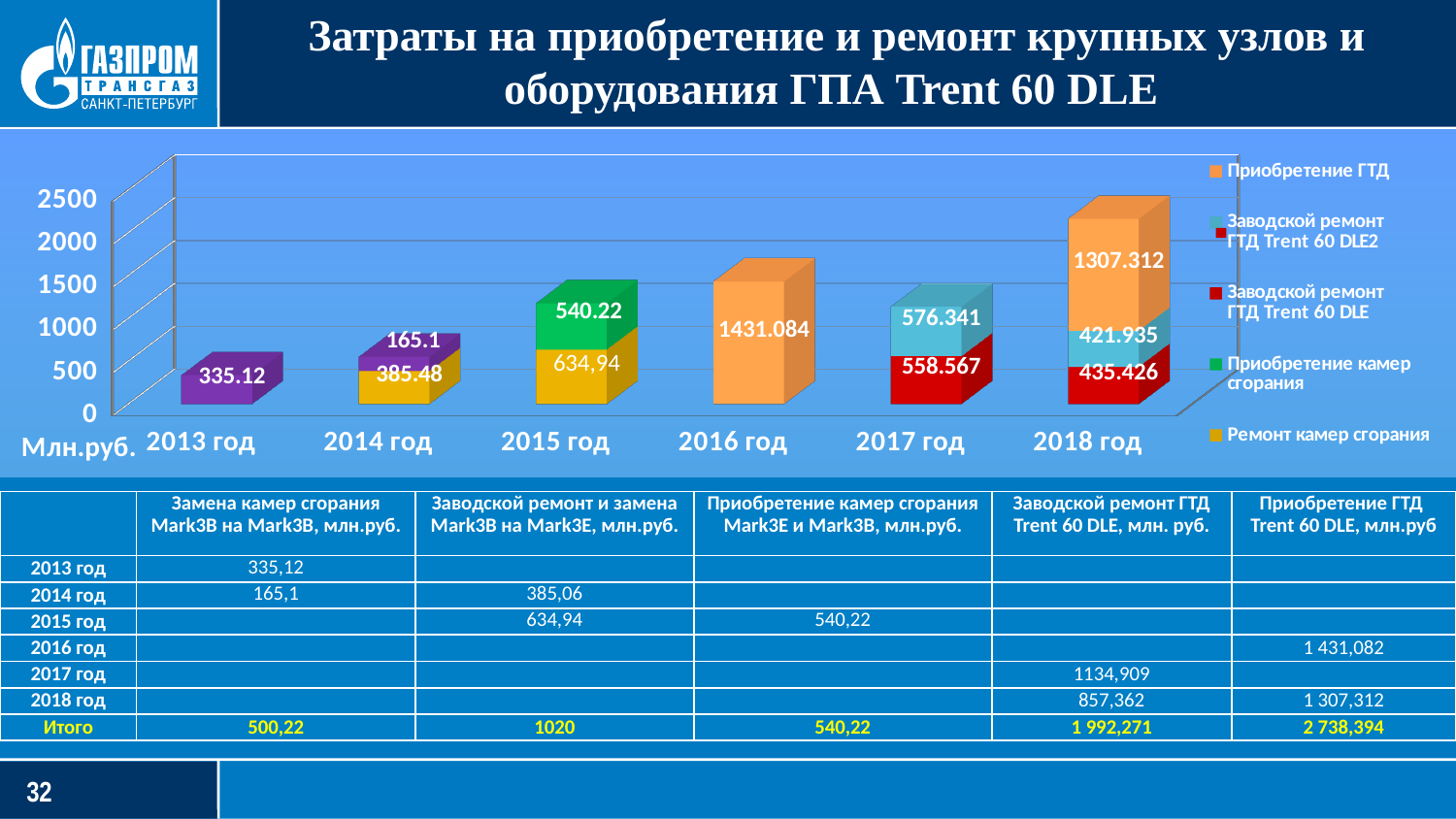
What is the difference between the orange segment values for 2016 год and 2018 год? 123.772 What is the value of the orange segment (Приобретение ГТД) for 2016 год? 1431.084 How many series does the chart legend list? 5 How many year categories are shown on the x axis of the chart? 6 What is the value of the orange segment (Приобретение ГТД) for 2018 год? 1307.312 What is the value of the single bar for 2013 год? 335.12 What type of chart is shown on the slide? bar chart Which year has the shortest bar in the chart? 2013 год Which year has the tallest stacked bar in the chart? 2018 год What is the value of the green segment (Приобретение камер сгорания) for 2015 год? 540.22 What is the value of the red segment (Заводской ремонт ГТД Trent 60 DLE) for 2017 год? 558.567 What is the total of the stacked bar for 2017 год? 1134.908